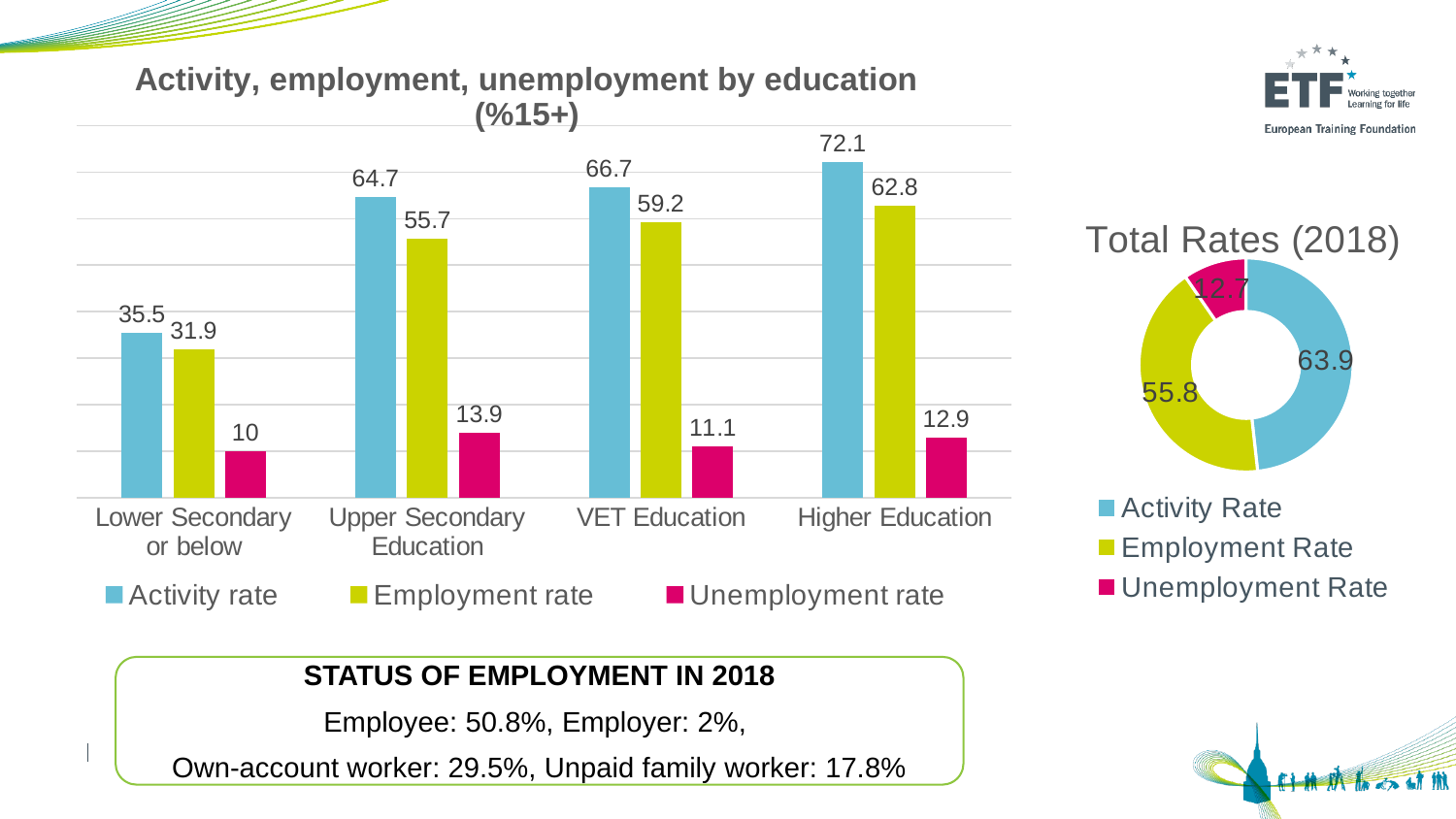
In the 'Activity, employment, unemployment by education (%15+)' chart, which is larger: the unemployment rate for Upper Secondary Education or for VET Education? Upper Secondary Education In the 'Activity, employment, unemployment by education (%15+)' chart, which education level has the lowest employment rate? Lower Secondary or below In the 'Activity, employment, unemployment by education (%15+)' chart, what is the unemployment rate for Lower Secondary or below? 10 How many series does the legend of the 'Activity, employment, unemployment by education (%15+)' chart list? 3 In the 'Activity, employment, unemployment by education (%15+)' chart, what is the difference between the activity rate and the employment rate for Upper Secondary Education? 9 In the 'Activity, employment, unemployment by education (%15+)' chart, what is the employment rate for VET Education? 59.2 In the 'Total Rates (2018)' chart, which rate has the smallest value? Unemployment Rate In the 'Activity, employment, unemployment by education (%15+)' chart, what is the activity rate for Higher Education? 72.1 In the 'Total Rates (2018)' chart, what is the value for Employment Rate? 55.8 How many education categories are shown in the 'Activity, employment, unemployment by education (%15+)' chart? 4 In the 'Activity, employment, unemployment by education (%15+)' chart, which education level has the highest activity rate? Higher Education What kind of chart is 'Activity, employment, unemployment by education (%15+)'? Bar chart